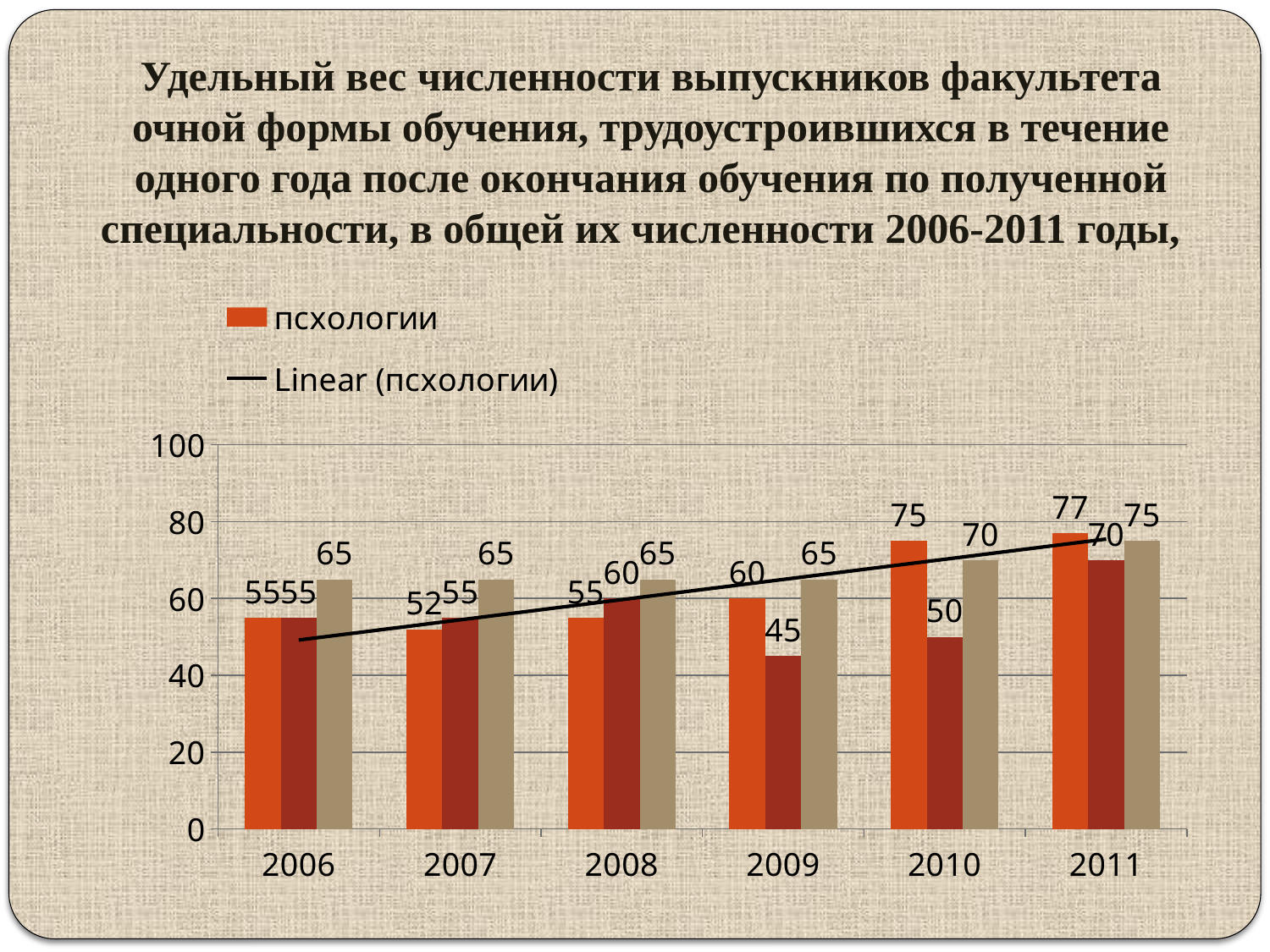
How many years are shown on the x axis? 6 What is the value for псхологии in 2010? 75 Is the value for псхологии in 2010 greater or less than 60? greater In which year is the value for псхологии highest? 2011 What is the difference between the псхологии values for 2011 and 2006? 22 Does the trend line for псхологии rise or fall from 2006 to 2011? rise What is the value for псхологии in 2011? 77 How many entries does the legend list? 2 In which year is the value for псхологии lowest? 2007 What kind of chart is shown on the slide? bar chart What is the value for псхологии in 2007? 52 Which year has the larger псхологии value, 2008 or 2009? 2009